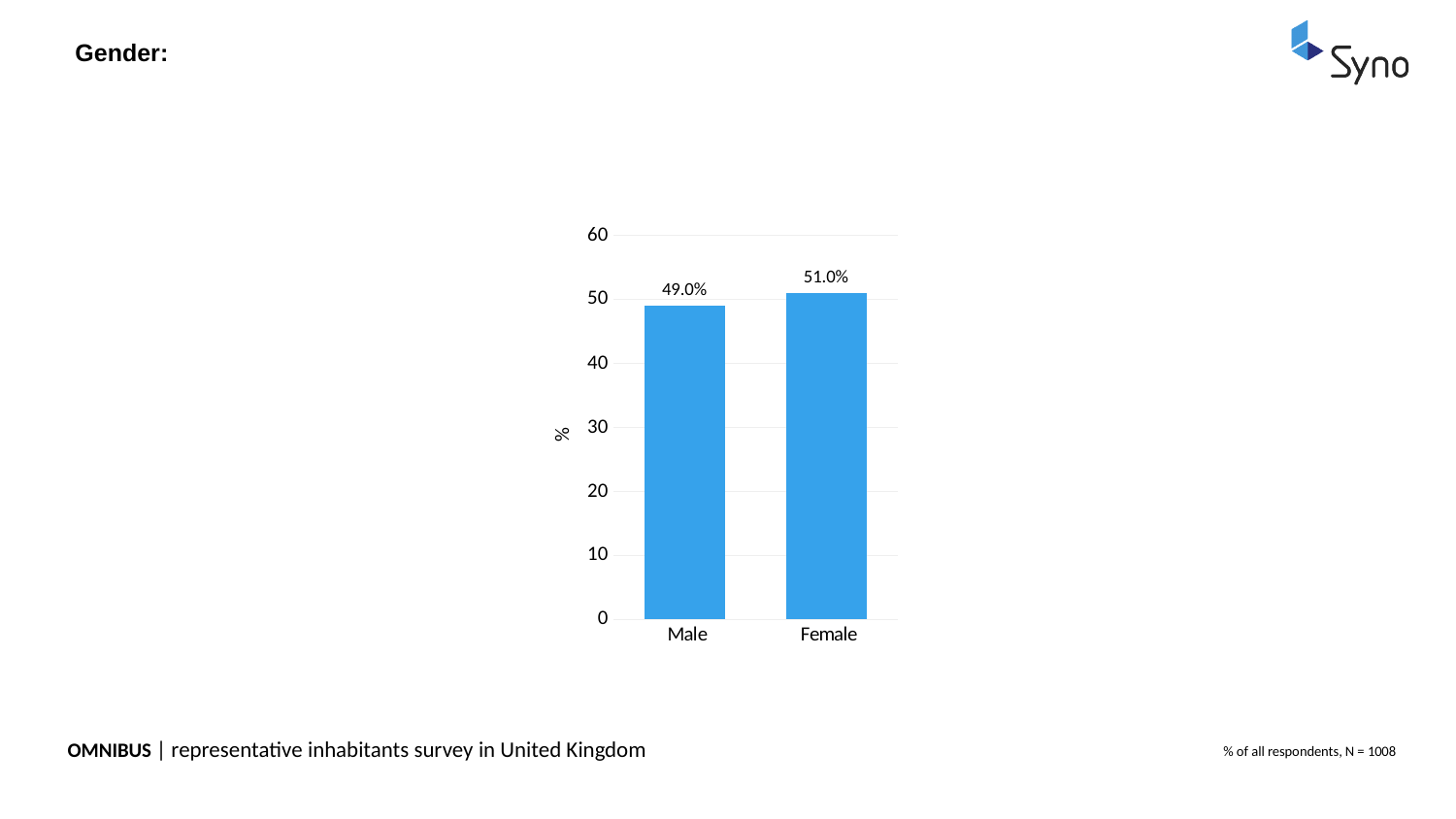
What is the highest tick value shown on the vertical axis? 60 What is the label on the vertical axis? % What is the value for Male? 49.0% What is the difference between the values for Female and Male? 2.0% Is the value for Male greater or less than 50? less Which category has the lowest value? Male How many categories are shown on the x axis? 2 What is the value for Female? 51.0% Which is larger, the value for Male or the value for Female? Female What kind of chart is shown on the slide? bar chart Is the value for Female greater or less than 40? greater Which category has the highest value? Female